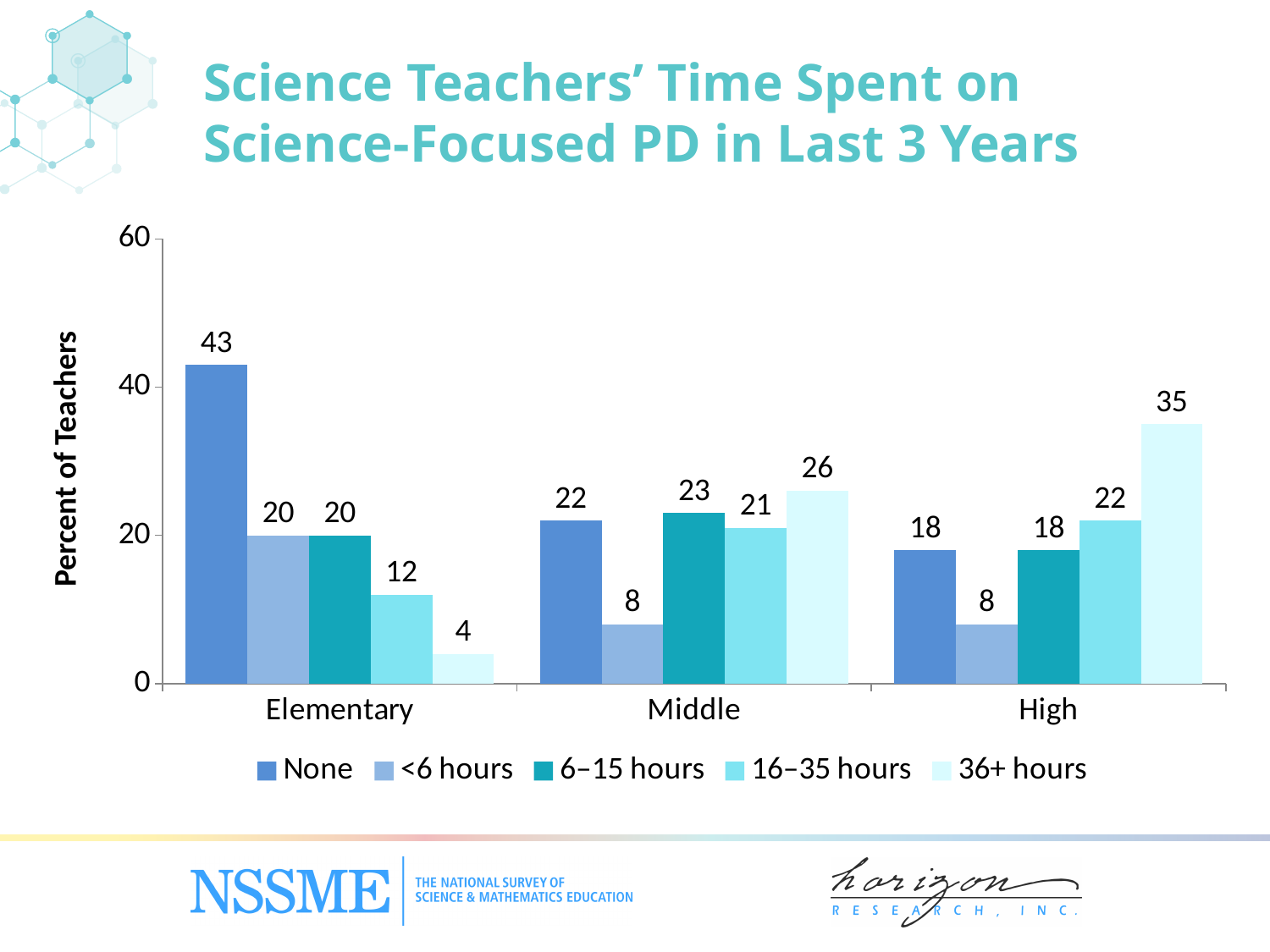
How many grade-level categories are shown on the x axis? 3 Which grade level has the lowest value for the None series? High What is the difference between the None value for Elementary and the None value for Middle? 21 Which grade level has the highest value for the 36+ hours series? High Is the value for 36+ hours among elementary teachers greater or less than 20? less What percent of elementary science teachers reported no science-focused PD in the last 3 years? 43 Which is larger for middle school teachers: 6–15 hours or 16–35 hours? 6–15 hours What is the value for <6 hours among middle school teachers? 8 What kind of chart is shown on the slide? bar chart What is the label of the y axis? Percent of Teachers What is the value for 36+ hours among high school teachers? 35 How many series does the legend list? 5